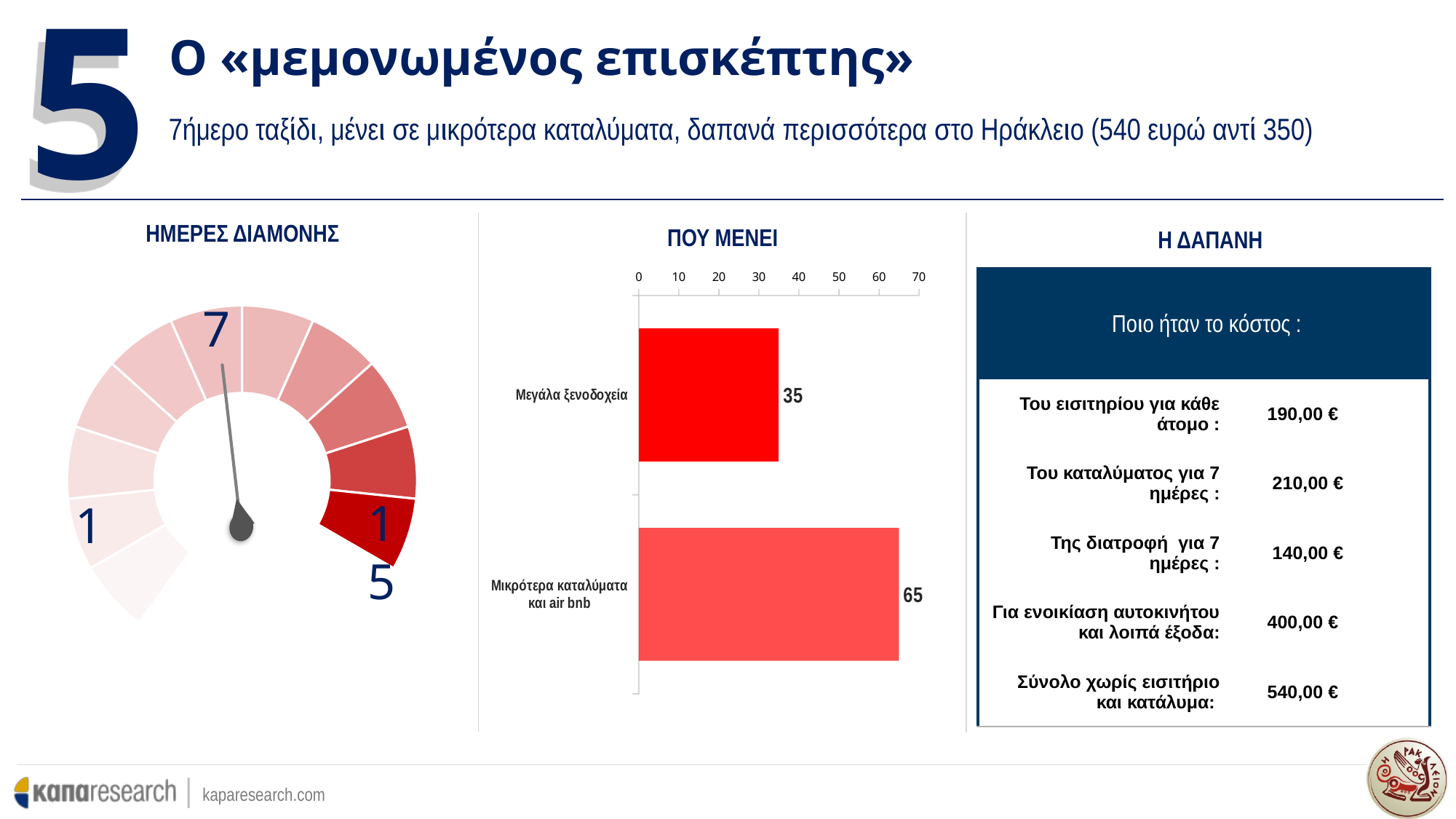
How many categories are shown in the ΠΟΥ ΜΕΝΕΙ chart? 2 In the ΠΟΥ ΜΕΝΕΙ chart, what is the difference between the values for Μικρότερα καταλύματα και air bnb and Μεγάλα ξενοδοχεία? 30 What is the highest tick value shown on the axis of the ΠΟΥ ΜΕΝΕΙ chart? 70 In the ΠΟΥ ΜΕΝΕΙ chart, is the value for Μικρότερα καταλύματα και air bnb greater or less than 60? greater In the ΠΟΥ ΜΕΝΕΙ chart, which category has the highest value? Μικρότερα καταλύματα και air bnb In the ΠΟΥ ΜΕΝΕΙ chart, is the value for Μεγάλα ξενοδοχεία greater or less than 40? less In the ΠΟΥ ΜΕΝΕΙ chart, what is the value for Μικρότερα καταλύματα και air bnb? 65 What kind of chart is the ΠΟΥ ΜΕΝΕΙ chart? bar chart In the ΠΟΥ ΜΕΝΕΙ chart, which is larger: Μεγάλα ξενοδοχεία or Μικρότερα καταλύματα και air bnb? Μικρότερα καταλύματα και air bnb In the ΠΟΥ ΜΕΝΕΙ chart, what is the value for Μεγάλα ξενοδοχεία? 35 In the ΠΟΥ ΜΕΝΕΙ chart, which category has the lowest value? Μεγάλα ξενοδοχεία What is the title of the chart in the middle of the slide? ΠΟΥ ΜΕΝΕΙ